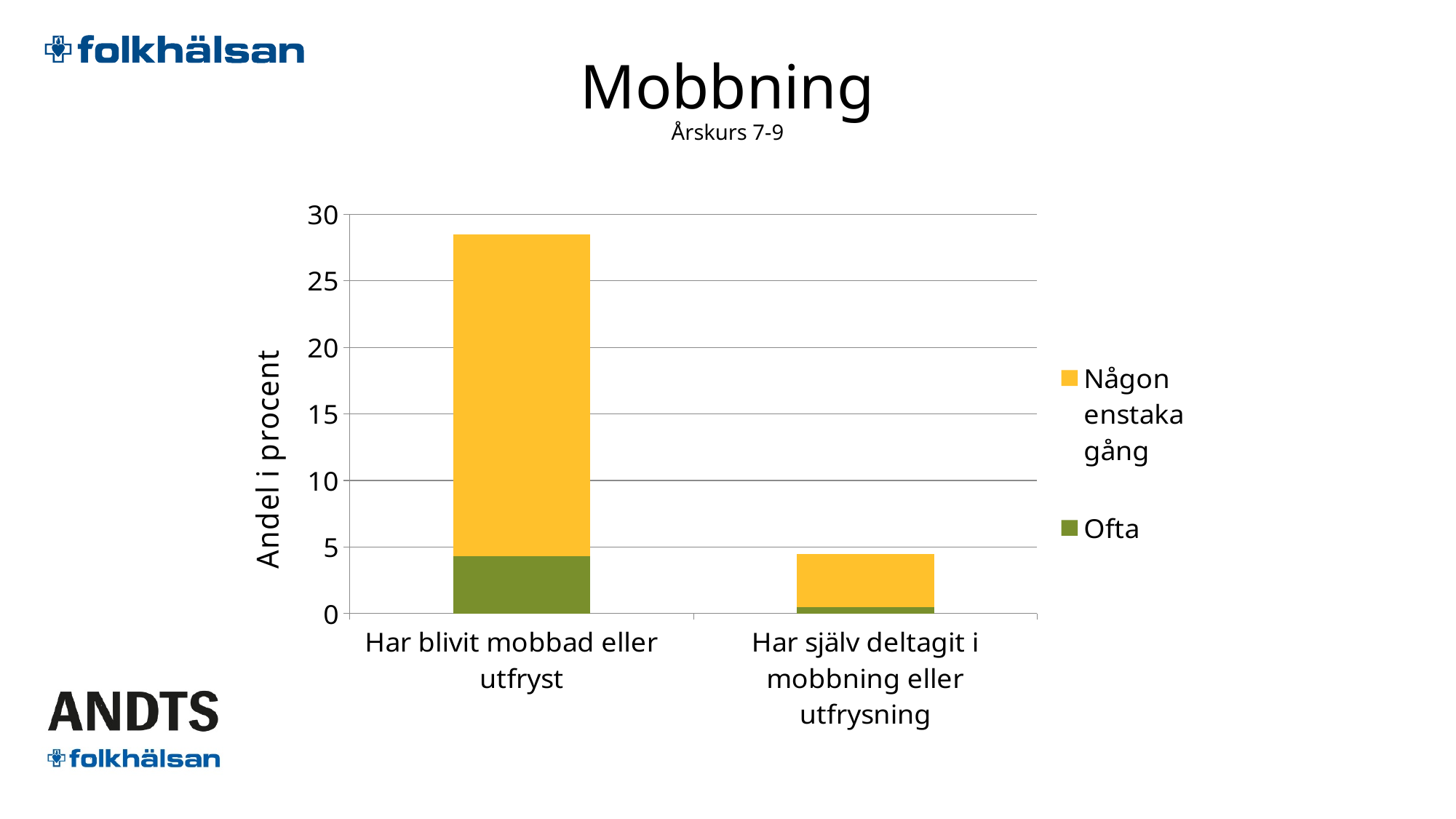
Is the 'Ofta' value for 'Har själv deltagit i mobbning eller utfrysning' greater or less than 5? less How many categories are shown on the x axis of the chart? 2 Is the 'Ofta' value for 'Har blivit mobbad eller utfryst' greater or less than 10? less Is the total stacked value for 'Har blivit mobbad eller utfryst' greater or less than 25? greater Which category has the shorter stacked bar overall? Har själv deltagit i mobbning eller utfrysning What kind of chart is shown on the slide? Stacked bar chart Which category has the taller stacked bar overall? Har blivit mobbad eller utfryst How many series does the chart's legend list? 2 What is the title of the chart's vertical axis? Andel i procent Which series is shown in green in the chart? Ofta In the category 'Har blivit mobbad eller utfryst', which series has the larger value, 'Någon enstaka gång' or 'Ofta'? Någon enstaka gång